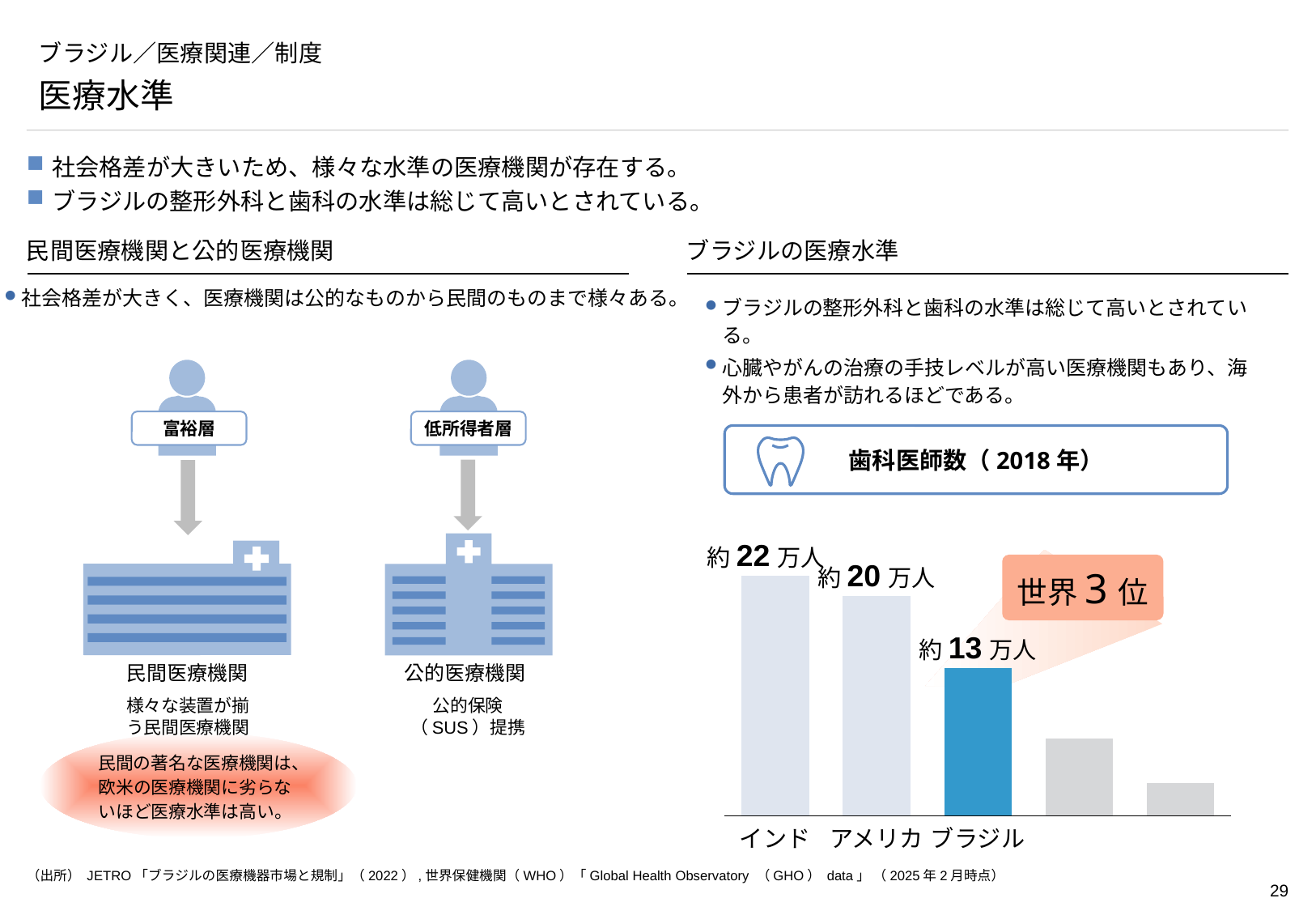
In the 歯科医師数 chart, which has more dentists, アメリカ or ブラジル? アメリカ In the 歯科医師数 chart, which of the three labeled countries has the lowest number of dentists? ブラジル In the 歯科医師数 chart, what value is labeled for インド? 約22万人 What kind of chart is shown under 歯科医師数（2018年）? bar chart In the 歯科医師数 chart, which has more dentists, インド or アメリカ? インド How many bars are drawn in the 歯科医師数 chart? 5 In the 歯科医師数 chart, what world ranking is shown in the callout next to the ブラジル bar? 世界3位 What is the title of the chart on the right side of the slide? 歯科医師数（2018年） In the 歯科医師数 chart, what value is labeled for ブラジル? 約13万人 In the 歯科医師数 chart, which labeled country has the highest number of dentists? インド In the 歯科医師数 chart, what value is labeled for アメリカ? 約20万人 How many bars in the 歯科医師数 chart are labeled with a country name? 3